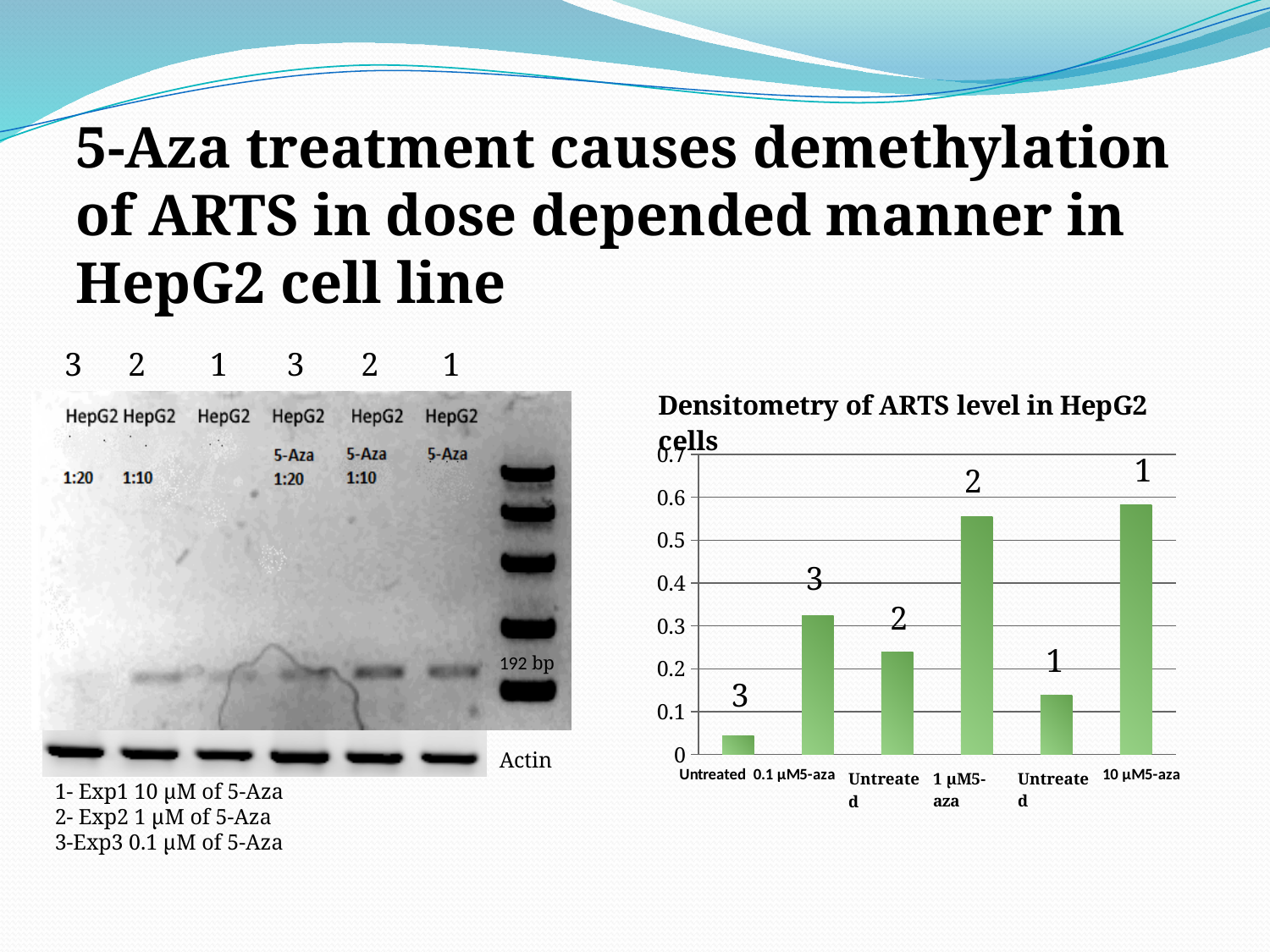
Is the value for 1 µM5-aza greater or less than 0.5? greater Is the value for the leftmost Untreated bar greater or less than 0.1? less What is the title of the chart on the slide? Densitometry of ARTS level in HepG2 cells What kind of chart is shown on the slide? bar chart What number is printed above the 10 µM5-aza bar? 1 Which category has the lowest bar in the Densitometry of ARTS level in HepG2 cells chart? Untreated (leftmost bar) Is the value for 10 µM5-aza greater or less than 0.5? greater How many bars are plotted in the Densitometry of ARTS level in HepG2 cells chart? 6 Which is larger, the value for 10 µM5-aza or the value for the Untreated bar immediately to its left? 10 µM5-aza Which is larger, the value for 1 µM5-aza or the value for 0.1 µM5-aza? 1 µM5-aza